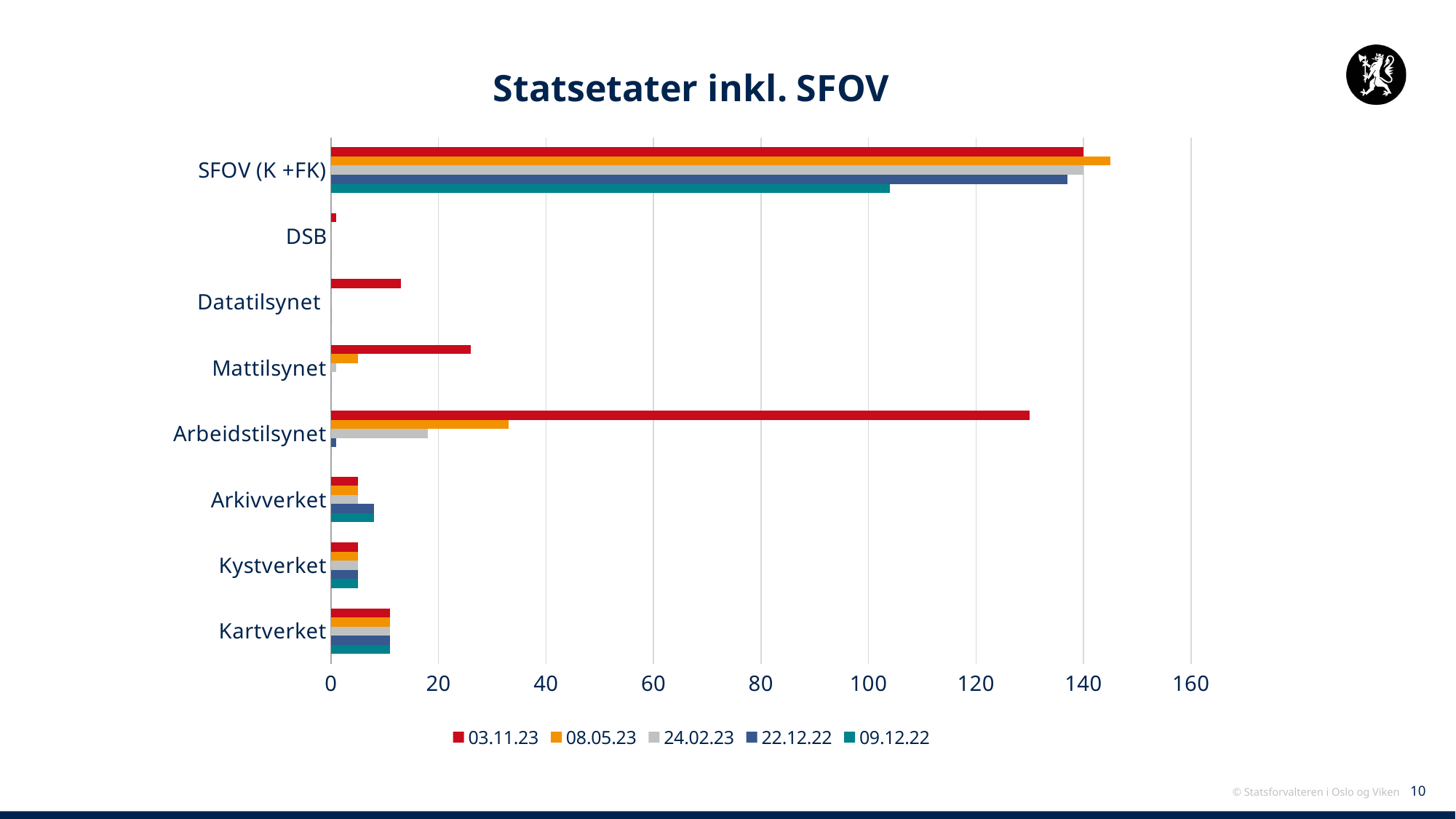
Which series is shown in red in the legend? 03.11.23 Is the value for Datatilsynet in the 03.11.23 series greater or less than 20? less What type of chart is shown on the slide? bar chart How many series does the legend list? 5 Is the value for SFOV (K +FK) in the 09.12.22 series greater or less than 100? greater Is the value for Mattilsynet in the 03.11.23 series greater or less than 20? greater In the 03.11.23 series, which is larger: Arbeidstilsynet or Mattilsynet? Arbeidstilsynet Which series has the lowest value for SFOV (K +FK)? 09.12.22 What is the title of the chart? Statsetater inkl. SFOV Which category has the highest value in the 03.11.23 series? SFOV (K +FK) How many categories are shown on the vertical axis of the chart? 8